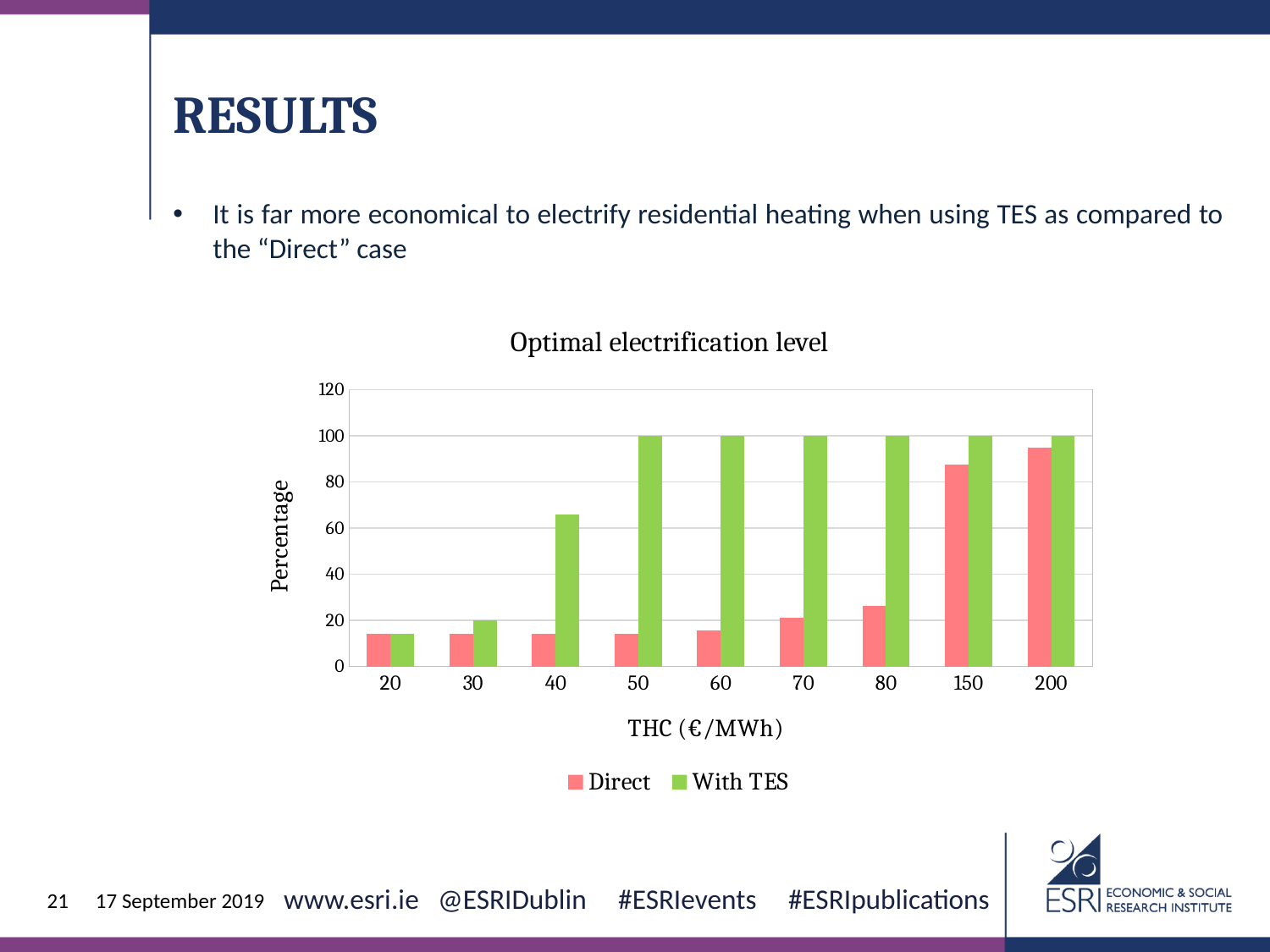
What kind of chart is shown on the slide? bar chart What is the label of the x axis of the chart? THC (€/MWh) Is the Direct value at a THC of 40 €/MWh greater or less than 20? less Is the Direct value at a THC of 150 €/MWh greater or less than 80? greater Is the With TES value at a THC of 40 €/MWh greater or less than 60? greater How many THC categories are shown on the x axis of the chart? 9 What is the title of the chart? Optimal electrification level At a THC of 70 €/MWh, which series has the larger value, Direct or With TES? With TES What is the With TES value at a THC of 50 €/MWh? 100 How many series does the chart's legend list? 2 Do the Direct values generally rise or fall as THC increases along the x axis? rise